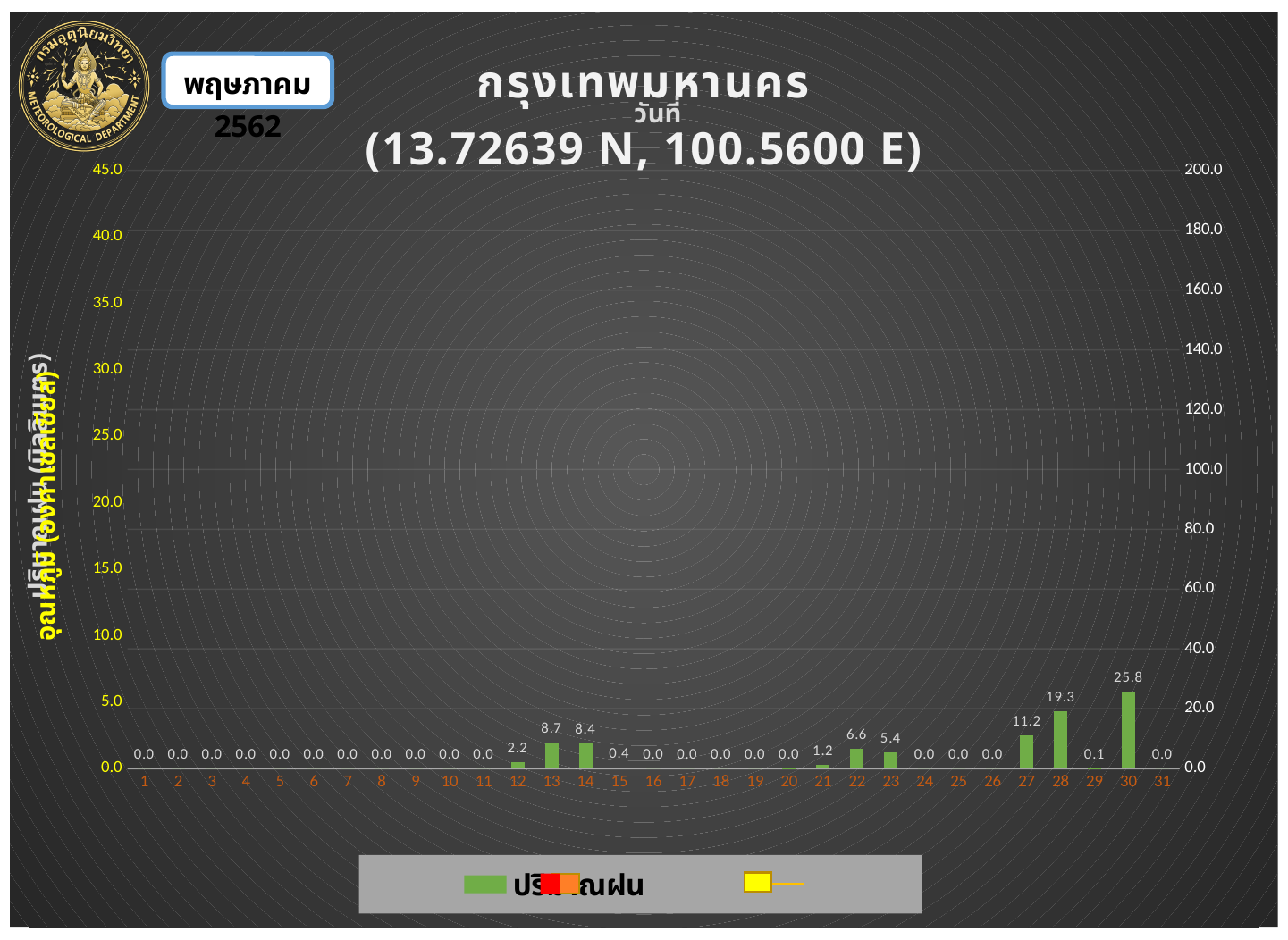
What is the difference between the rainfall values for day 30 and day 28? 6.5 Which has a larger rainfall value, day 22 or day 21? day 22 What are the coordinates shown in the chart title? 13.72639 N, 100.5600 E What is the rainfall value plotted for day 30? 25.8 What kind of chart is used to show the rainfall values? bar chart Which day has the highest rainfall value on the chart? 30 What is the rainfall value plotted for day 28? 19.3 How many days are shown on the x axis of the chart? 31 What is the rainfall value plotted for day 22? 6.6 Which has a larger rainfall value, day 13 or day 14? day 13 What is the rainfall value plotted for day 13? 8.7 What is the difference between the rainfall values for day 27 and day 23? 5.8